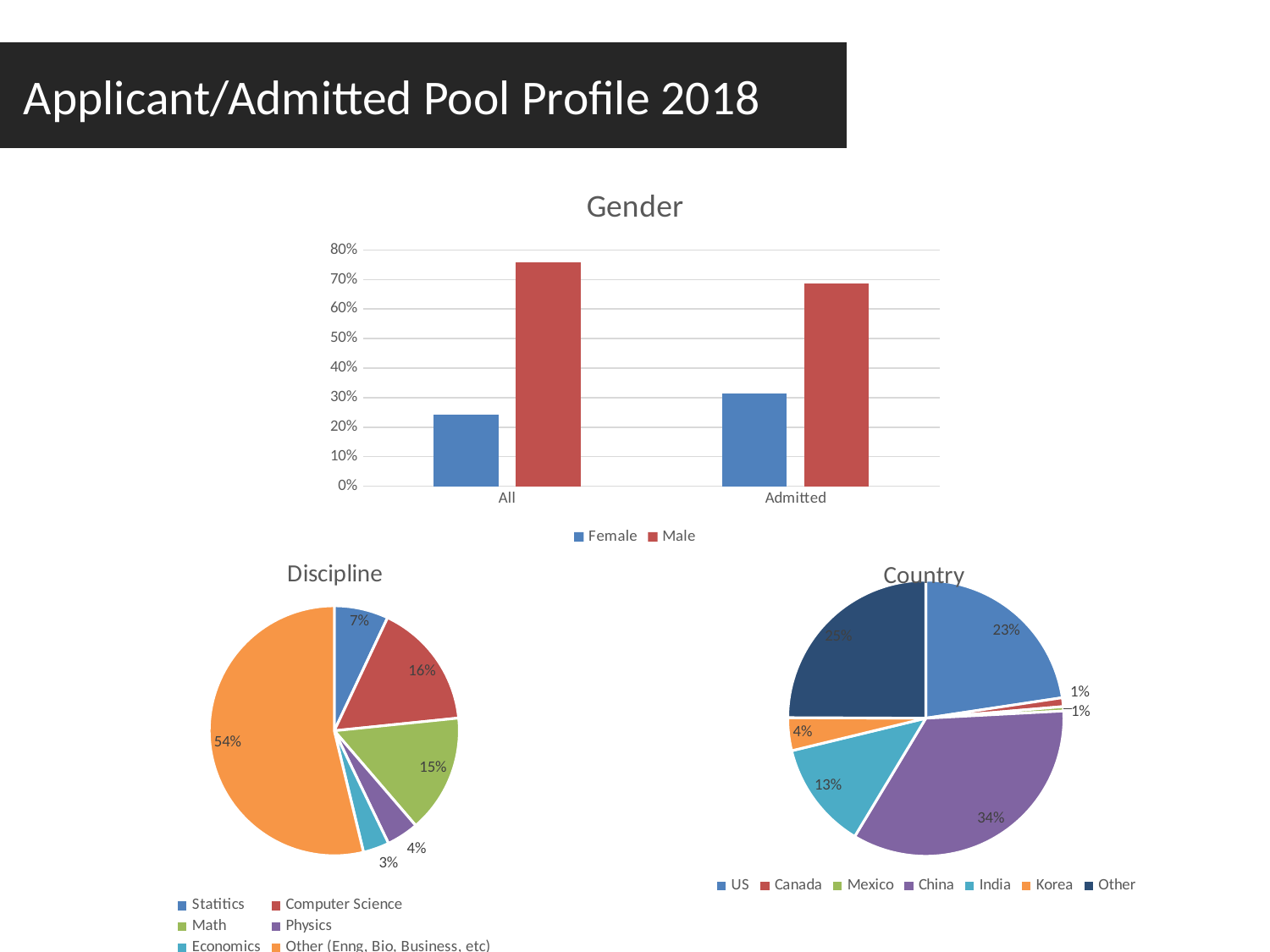
In the Gender chart, which is larger: the Female value for All or the Female value for Admitted? Admitted How many countries or categories does the Country pie chart show? 7 In the Country pie chart, what is the difference between the US share and the India share? 10% In the Gender chart, is the Female value for Admitted greater or less than 40%? less What kind of chart is the Gender chart? bar chart In the Discipline pie chart, which discipline has the largest share? Other (Enng, Bio, Business, etc) In the Country pie chart, what share is China? 34% In the Gender chart, is the Male value for All greater or less than 70%? greater How many series does the legend of the Gender chart list? 2 In the Discipline pie chart, what share is Computer Science? 16% In the Discipline pie chart, what is the difference between the Math share and the Physics share? 11% In the Country pie chart, which country has the largest share? China